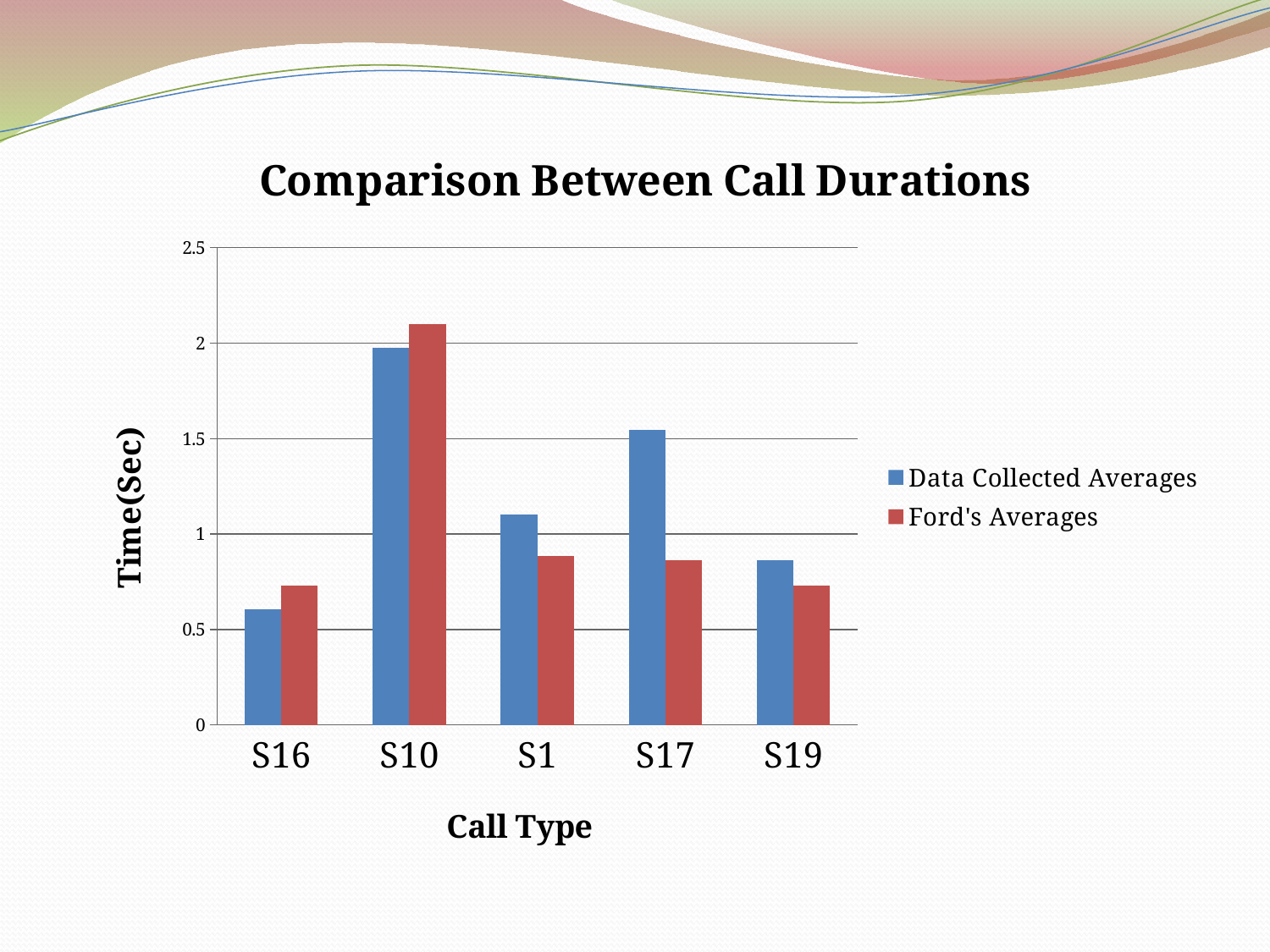
For S17, which is larger: Data Collected Averages or Ford's Averages? Data Collected Averages Is the Data Collected Averages value for S16 greater or less than 1? less For S16, which is larger: Data Collected Averages or Ford's Averages? Ford's Averages How many series does the legend list? 2 What type of chart is shown on the slide? Bar chart Is the Data Collected Averages value for S10 greater or less than 1.5? greater How many call types are shown on the x axis? 5 Which call type has the lowest Data Collected Averages value? S16 Is the Ford's Averages value for S1 greater or less than 1? less Which call type has the highest Ford's Averages value? S10 Which call type has the highest Data Collected Averages value? S10 What is the label of the y axis? Time(Sec)